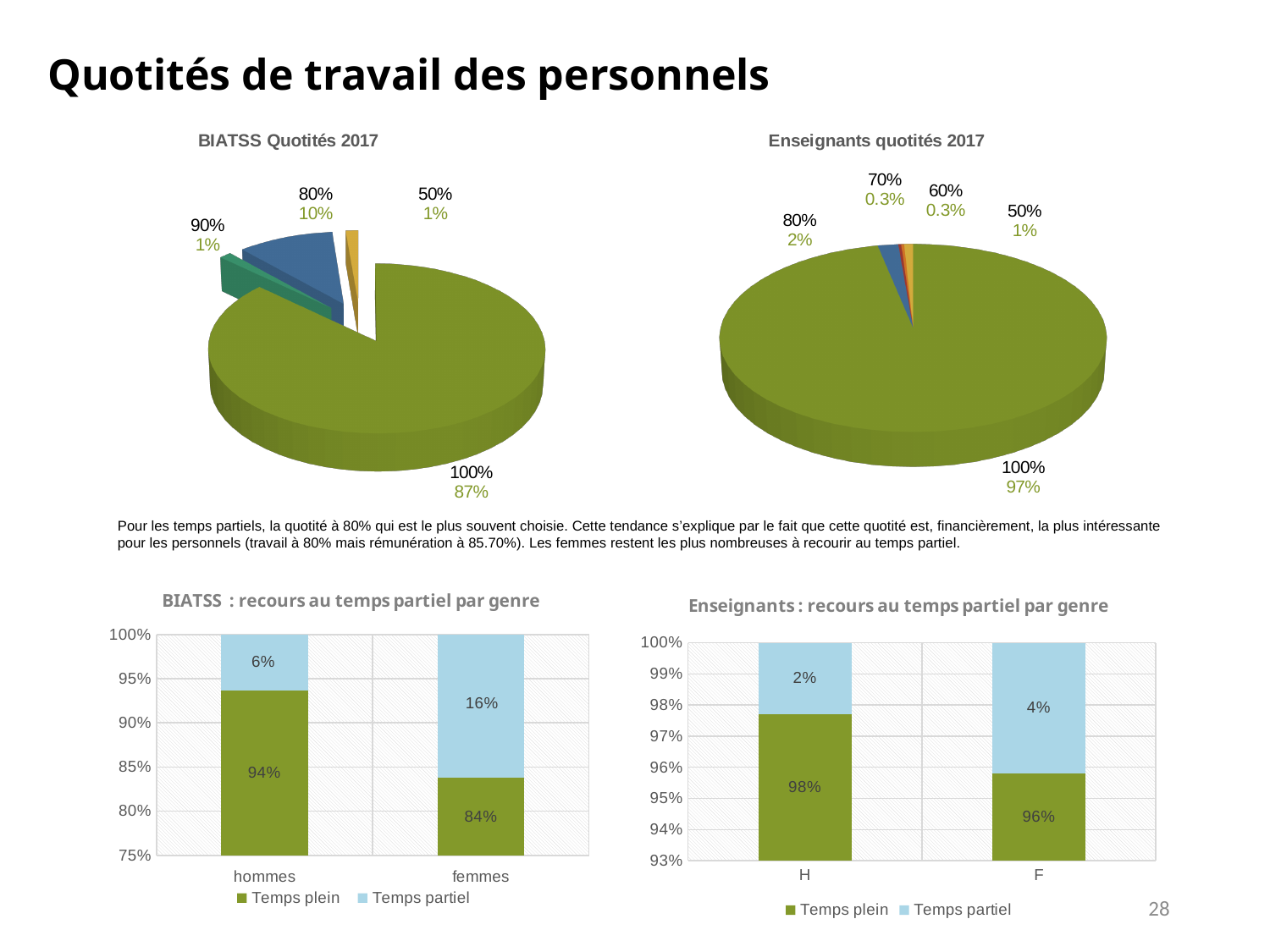
In the 'BIATSS Quotités 2017' chart, what share of staff work at the 80% quotité? 10% What kind of chart is 'BIATSS : recours au temps partiel par genre'? Stacked bar chart In the 'Enseignants quotités 2017' chart, what share of staff work at the 80% quotité? 2% How many series does the legend of the 'Enseignants : recours au temps partiel par genre' chart list? 2 In the 'Enseignants quotités 2017' chart, how many slices are labelled? 5 In the 'BIATSS Quotités 2017' chart, what share of staff work at the 100% quotité? 87% In the 'BIATSS : recours au temps partiel par genre' chart, what is the Temps partiel value for femmes? 16% What kind of chart is 'BIATSS Quotités 2017'? Pie chart In the 'Enseignants : recours au temps partiel par genre' chart, what is the Temps partiel value for F? 4% In the 'BIATSS : recours au temps partiel par genre' chart, what is the difference between the Temps plein values for hommes and femmes? 10% In the 'Enseignants : recours au temps partiel par genre' chart, which category has the larger Temps plein value, H or F? H In the 'Enseignants quotités 2017' chart, which quotité has the largest share? 100%